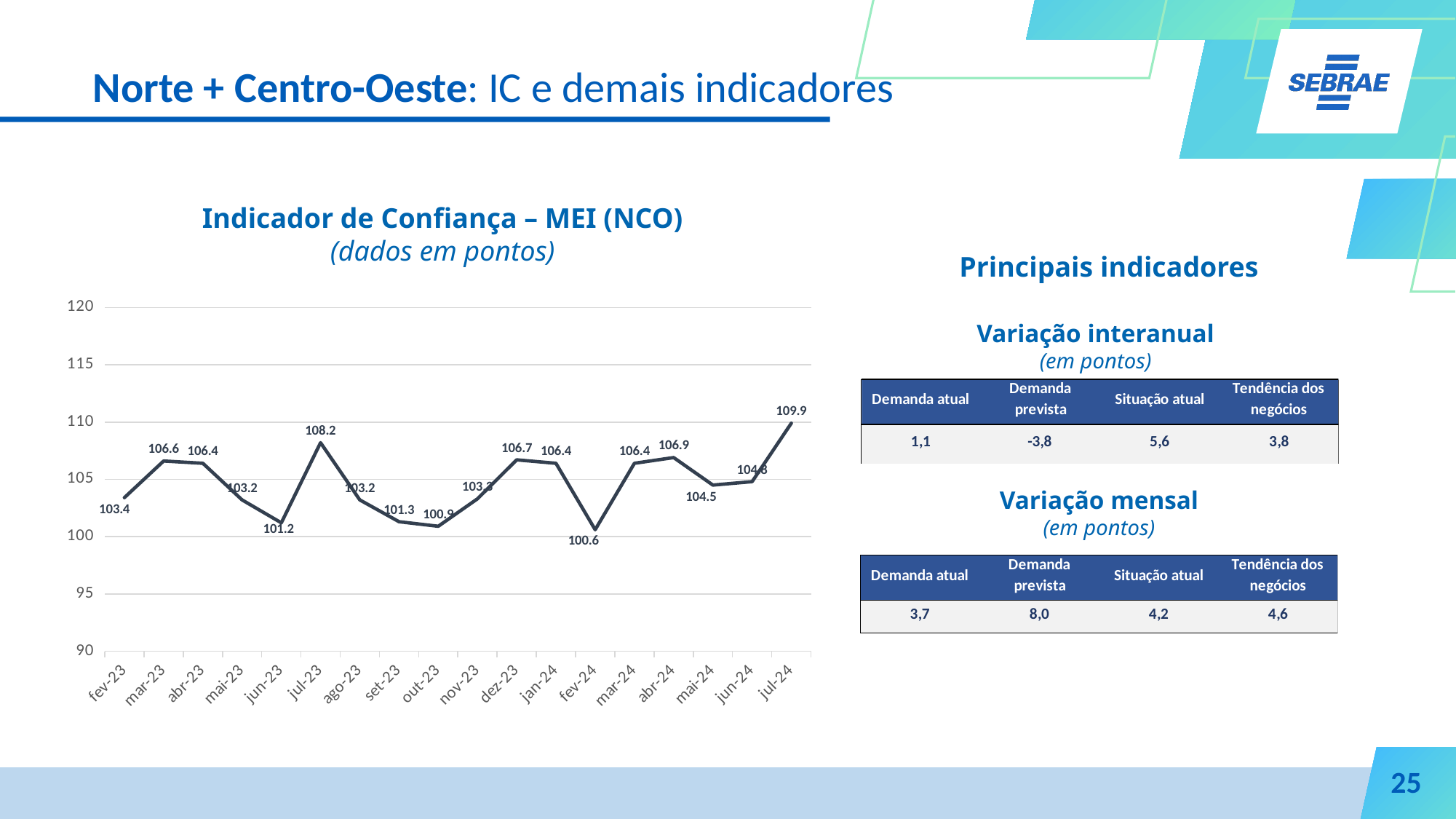
How many monthly data points are plotted on the Indicador de Confiança – MEI (NCO) chart? 18 What is the difference between the values for jul-24 and fev-24 on the Indicador de Confiança – MEI (NCO) chart? 9.3 What is the value for jul-23 on the Indicador de Confiança – MEI (NCO) chart? 108.2 What kind of chart is the Indicador de Confiança – MEI (NCO) chart? line chart What is the difference between the values for jul-23 and jun-23 on the Indicador de Confiança – MEI (NCO) chart? 7.0 Which month has the lowest value on the Indicador de Confiança – MEI (NCO) chart? fev-24 On the Indicador de Confiança – MEI (NCO) chart, is the value for out-23 greater or less than 105? less What is the value for jul-24 on the Indicador de Confiança – MEI (NCO) chart? 109.9 Which month has the highest value on the Indicador de Confiança – MEI (NCO) chart? jul-24 On the Indicador de Confiança – MEI (NCO) chart, which is larger, the value for mar-23 or the value for abr-23? mar-23 What is the value for fev-24 on the Indicador de Confiança – MEI (NCO) chart? 100.6 On the Indicador de Confiança – MEI (NCO) chart, does the value rise or fall from mai-24 to jul-24? rise